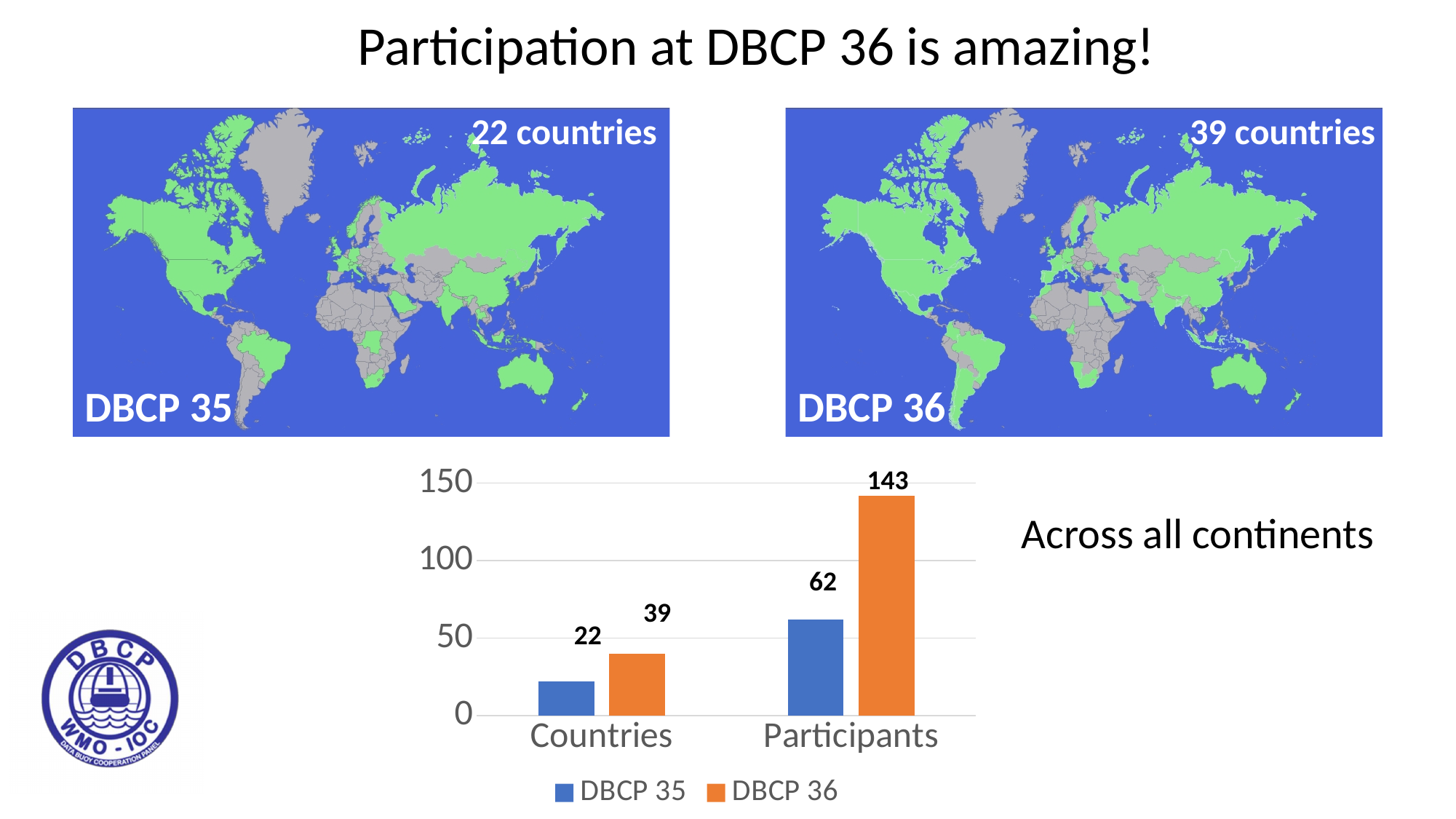
Which bar in the chart has the lowest value? Countries, DBCP 35 How many categories are shown on the x axis of the bar chart? 2 What is the difference between the DBCP 36 and DBCP 35 values for Countries? 17 Which bar in the chart has the highest value? Participants, DBCP 36 What is the number of Participants for DBCP 35 in the bar chart? 62 What is the difference between the DBCP 36 and DBCP 35 values for Participants? 81 Which is larger: the DBCP 35 value for Participants or the DBCP 36 value for Countries? DBCP 35 value for Participants What kind of chart is shown at the bottom of the slide? Bar chart What is the number of Countries for DBCP 36 in the bar chart? 39 How many series does the legend of the bar chart list? 2 What is the number of Countries for DBCP 35 in the bar chart? 22 What is the number of Participants for DBCP 36 in the bar chart? 143